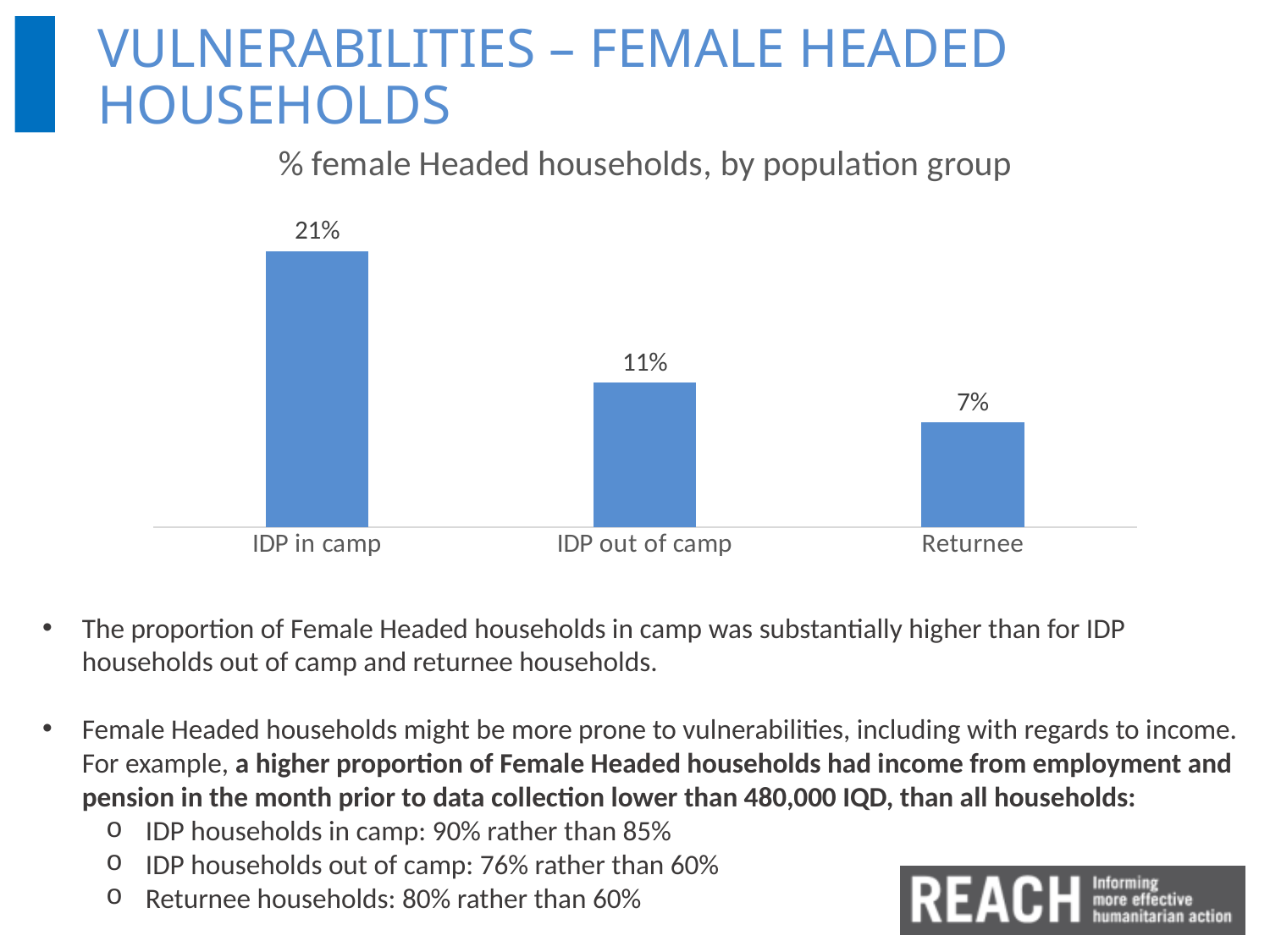
What is the title of the chart? % female Headed households, by population group Which population group has the lowest percentage of female headed households? Returnee Which population group has the highest percentage of female headed households? IDP in camp What is the value for Returnee? 7% Do the values rise or fall from left to right across the x axis? Fall What kind of chart is shown on the slide? Bar chart What is the value for IDP in camp? 21% What is the difference between the values for IDP in camp and IDP out of camp? 10% What is the value for IDP out of camp? 11% Which is larger, the value for IDP out of camp or the value for Returnee? IDP out of camp How many population groups are shown in the chart? 3 What is the difference between the values for IDP out of camp and Returnee? 4%